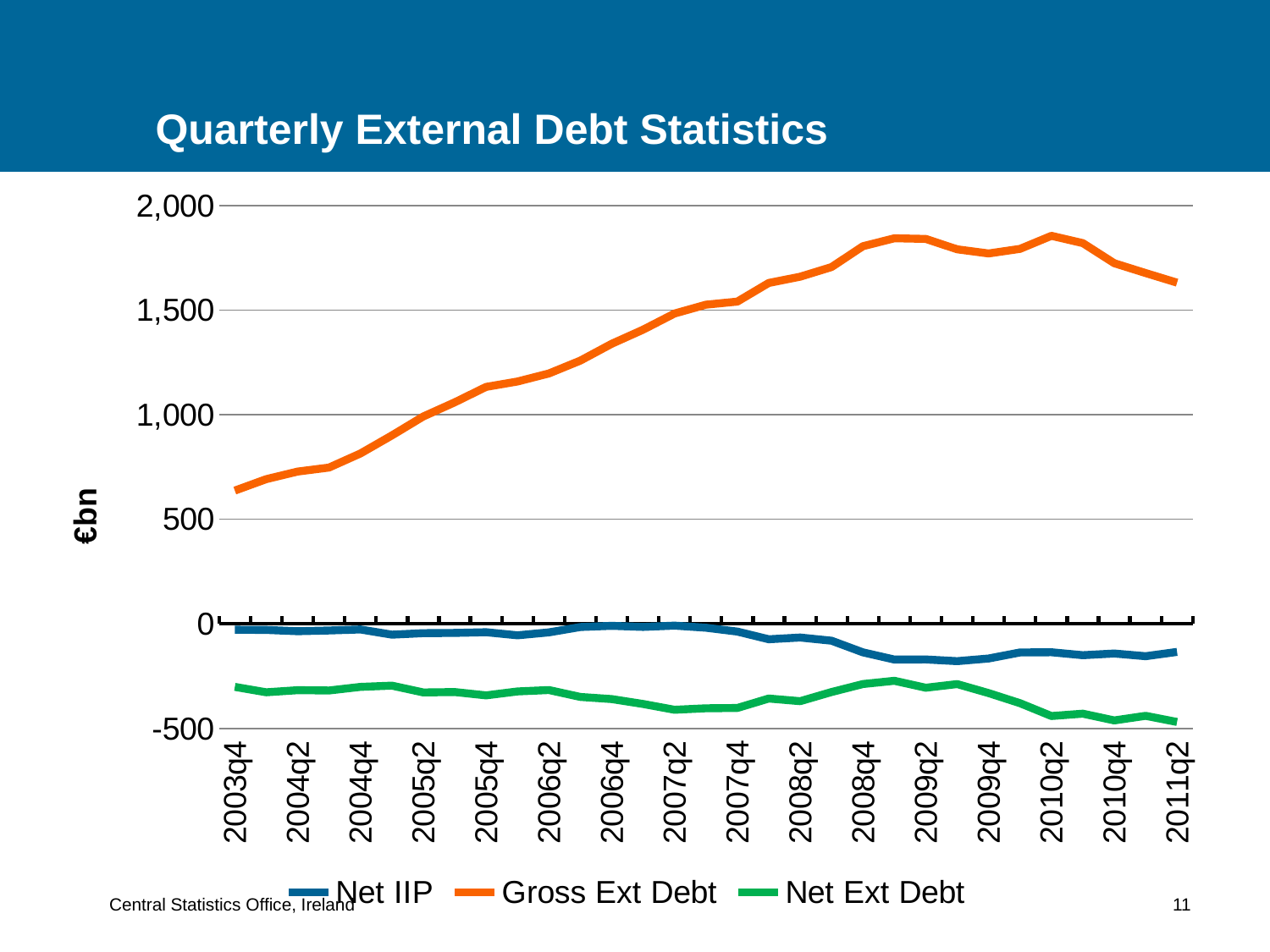
Is the value for Gross Ext Debt at 2003q4 greater or less than 1,000? less At 2005q4, which is larger: Net IIP or Net Ext Debt? Net IIP Which series has the highest values throughout the chart? Gross Ext Debt How many series does the legend list? 3 Which series has the lowest values throughout the chart? Net Ext Debt Is the value for Gross Ext Debt at 2010q2 greater or less than 1,500? greater What is the title of the chart? Quarterly External Debt Statistics Is the value for Net Ext Debt at 2003q4 greater or less than -500? greater Does Gross Ext Debt rise or fall from 2003q4 to 2008q4? rise What unit is shown on the vertical axis label? €bn What kind of chart is shown on the slide? line chart